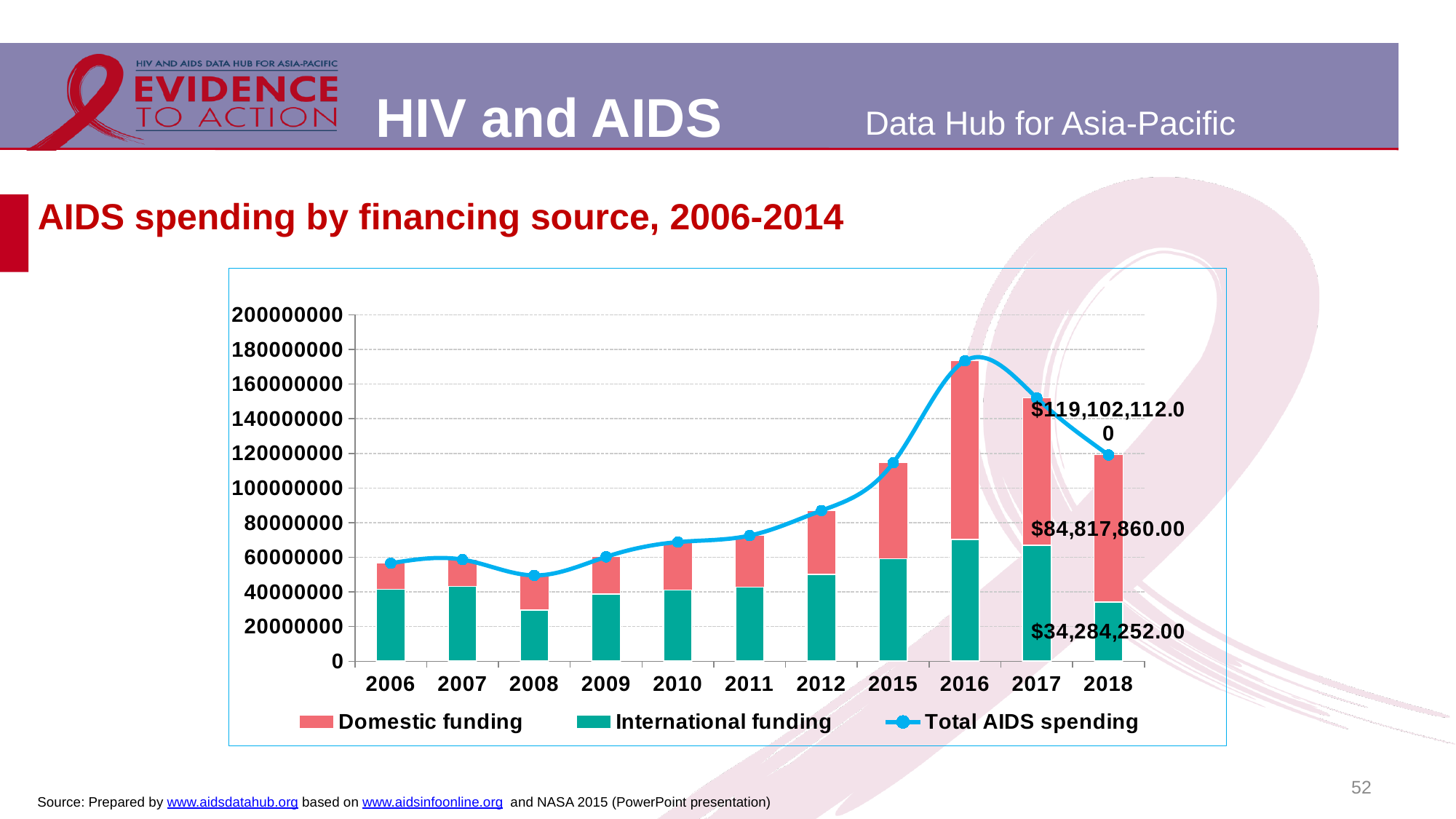
What is the Total AIDS spending value labelled for 2018? $119,102,112.00 How many years are shown on the x axis? 11 In 2018, which is larger: Domestic funding or International funding? Domestic funding What is the difference between Domestic funding and International funding in 2018? $50,533,608.00 What is the International funding value labelled for 2018? $34,284,252.00 Is the Total AIDS spending for 2008 greater or less than 60000000? less Which year has the lowest Total AIDS spending? 2008 Is the Total AIDS spending for 2016 greater or less than 160000000? greater Does Total AIDS spending rise or fall from 2016 to 2018? fall How many series does the legend list? 3 Which year has the highest Total AIDS spending? 2016 What is the Domestic funding value labelled for 2018? $84,817,860.00